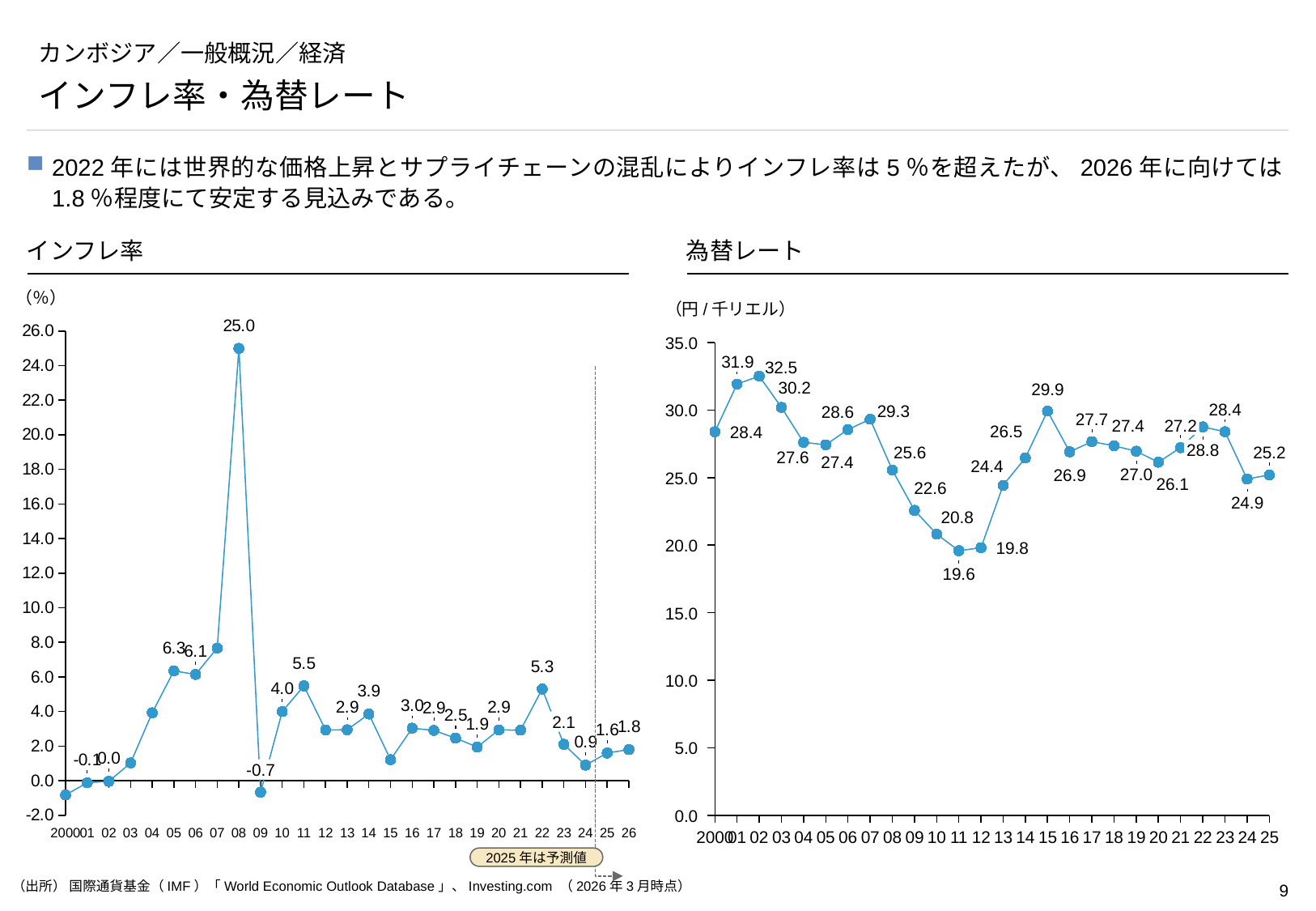
In the インフレ率 chart, which year has the highest inflation rate? 2008 In the インフレ率 chart, is the value for 2007 greater or less than 6.0? greater In the インフレ率 chart, what is the value for 2026? 1.8 What kind of chart is the 為替レート chart? line chart In the 為替レート chart, what is the value for 2015? 29.9 In the 為替レート chart, do the values rise or fall from 2007 to 2011? fall In the 為替レート chart, what is the difference between the 2002 and 2011 values? 12.9 In the 為替レート chart, which year has the lowest value? 2011 In the インフレ率 chart, what is the inflation rate for 2008? 25.0 In the 為替レート chart, which year has the highest value? 2002 In the インフレ率 chart, what is the value for 2022? 5.3 In the インフレ率 chart, what is the difference between the 2022 and 2023 values? 3.2